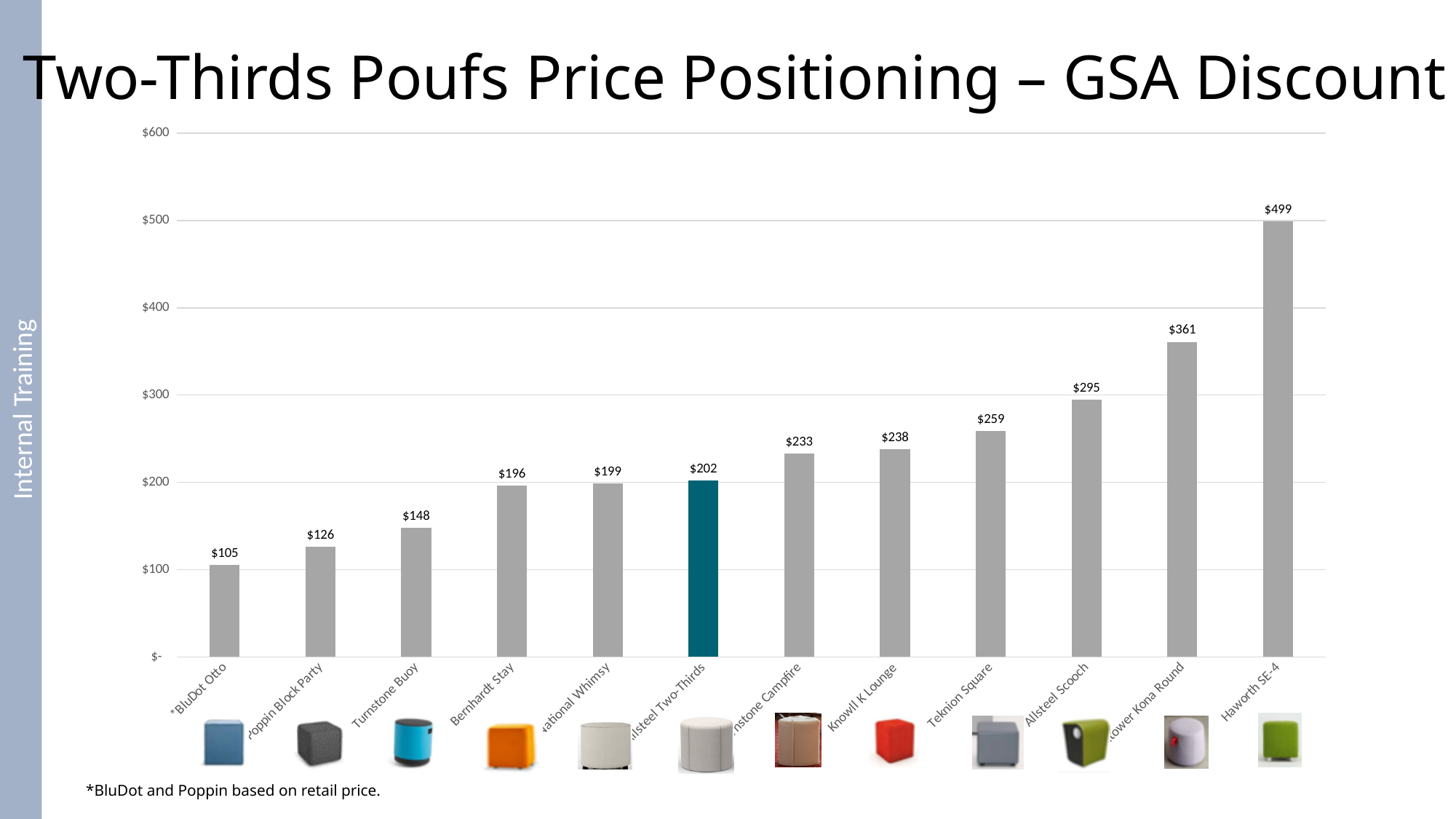
Which product has the highest price on the chart? Haworth SE-4 What is the price shown for Haworth SE-4? $499 Which product has the lowest price on the chart? *BluDot Otto What value is labelled on the single teal-coloured bar? $202 What is the price shown for Teknion Square? $259 Which is priced higher, Bernhardt Stay or Knowll K Lounge? Knowll K Lounge Is the value for Allsteel Scooch greater or less than $300? less How much more expensive is Haworth SE-4 than Allsteel Scooch? $204 Do the bar values rise or fall from left to right along the x axis? rise What is the price shown for Turnstone Buoy? $148 What kind of chart is shown on the slide? bar chart How many products (bars) are shown on the chart? 12